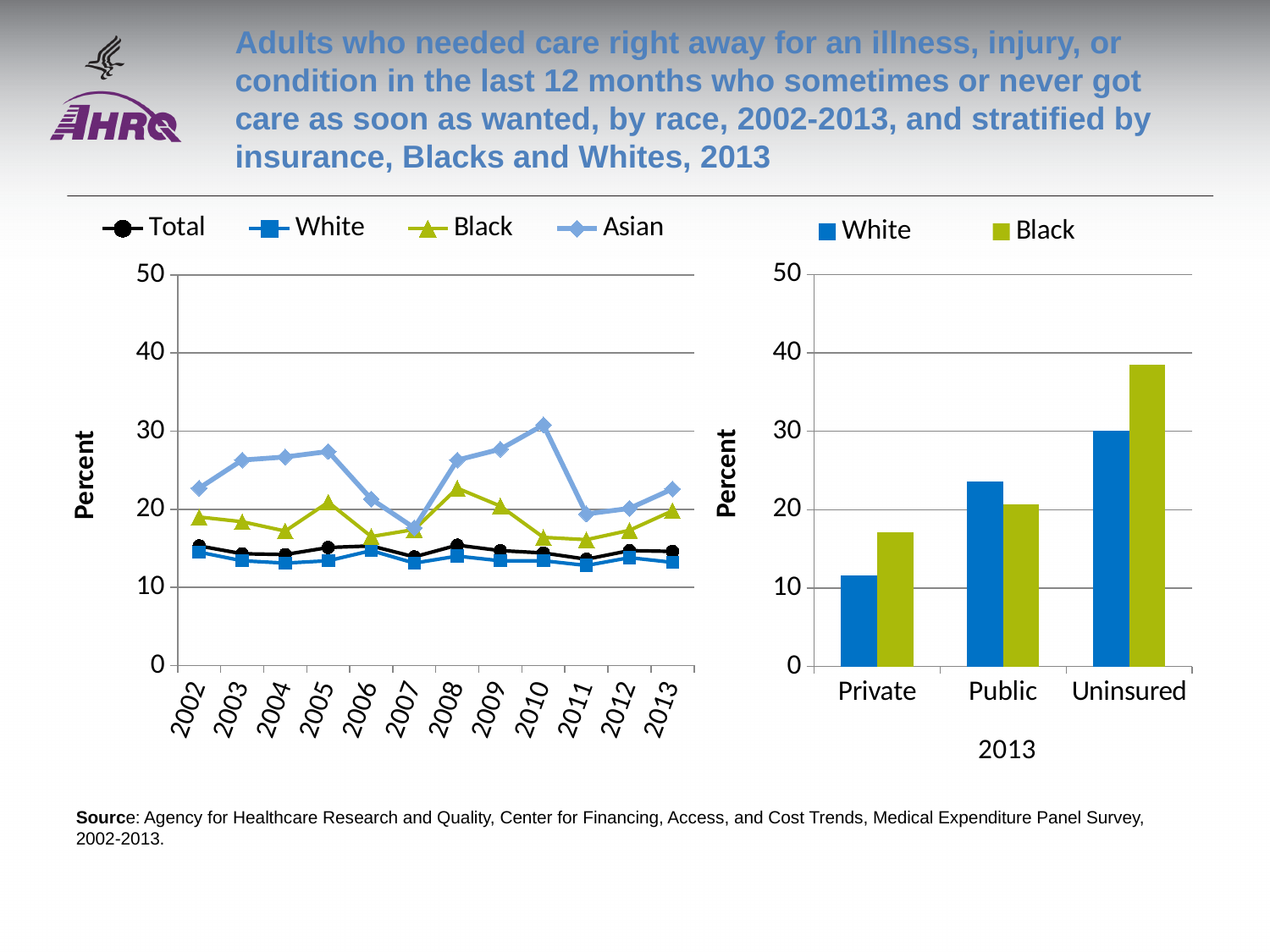
In the bar chart on the right, which bar is the lowest? White, Private In the bar chart on the right, is the value for Black in the Uninsured category greater or less than 30? greater In the line chart on the left, is the value for Black in 2008 greater or less than 20? greater In the line chart on the left, is the value for Asian in 2007 greater or less than 20? less In the bar chart on the right, how many insurance categories are shown on the x axis? 3 In the line chart on the left, how many years are shown on the x axis? 12 In the line chart on the left, which series has the highest value in 2010? Asian In the line chart on the left, how many series does the legend list? 4 What kind of chart is the chart on the left of the slide? line chart In the bar chart on the right, how many series does the legend list? 2 What kind of chart is the chart on the right of the slide? bar chart In the bar chart on the right, which bar is the highest? Black, Uninsured